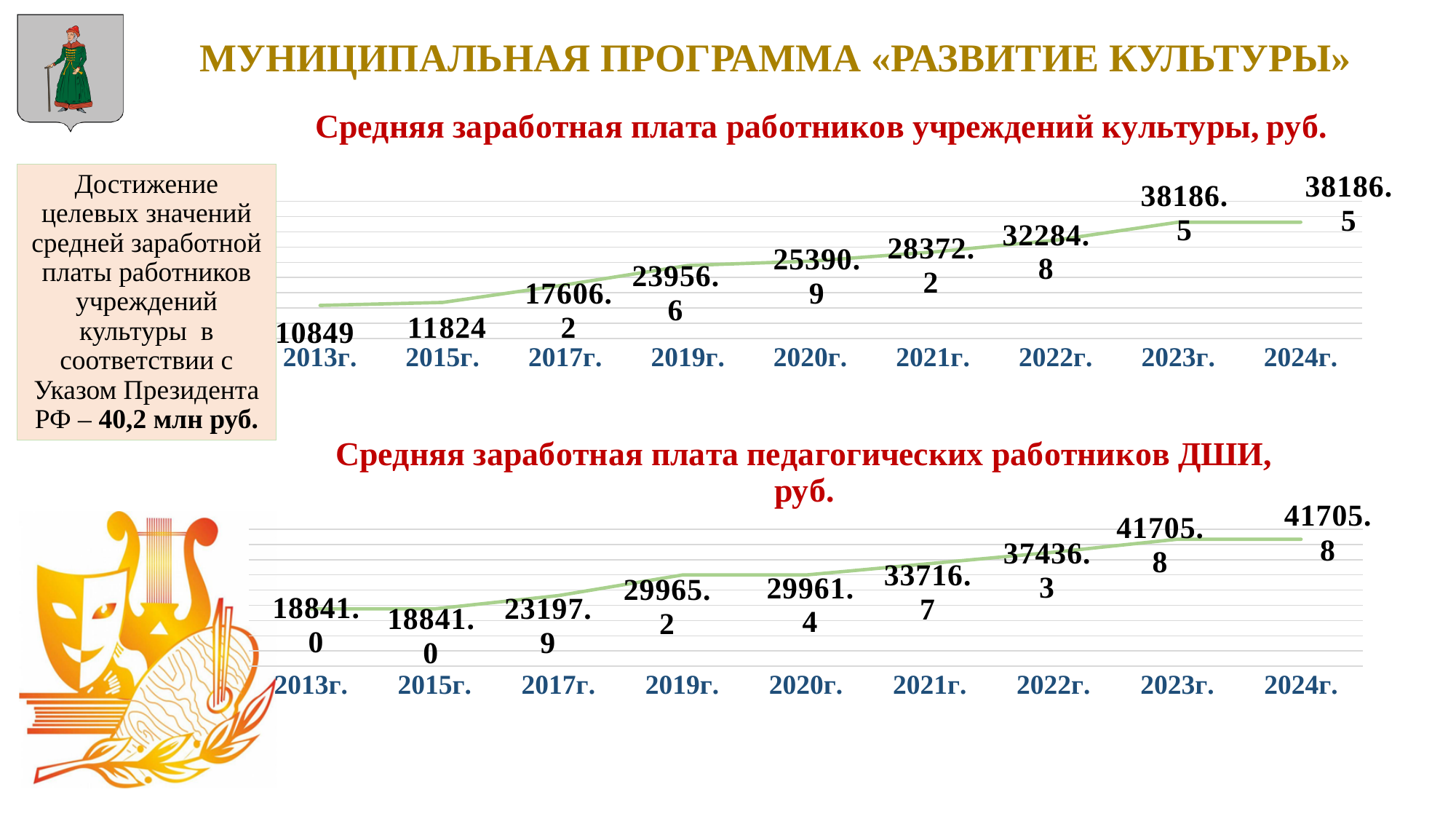
In the chart 'Средняя заработная плата работников учреждений культуры, руб.', what is the difference between the values for 2022г. and 2021г.? 3912.6 In the chart 'Средняя заработная плата педагогических работников ДШИ, руб.', what is the value for 2022г.? 37436.3 In the chart 'Средняя заработная плата работников учреждений культуры, руб.', which year has the lowest value? 2013г. In the chart 'Средняя заработная плата работников учреждений культуры, руб.', how many years are shown on the x axis? 9 What type of chart is 'Средняя заработная плата работников учреждений культуры, руб.'? line chart In the chart 'Средняя заработная плата педагогических работников ДШИ, руб.', which is larger, the value for 2019г. or the value for 2021г.? 2021г. In the chart 'Средняя заработная плата работников учреждений культуры, руб.', what is the value for 2021г.? 28372.2 In the chart 'Средняя заработная плата работников учреждений культуры, руб.', what is the value for 2024г.? 38186.5 In the chart 'Средняя заработная плата работников учреждений культуры, руб.', what is the value for 2013г.? 10849 In the chart 'Средняя заработная плата педагогических работников ДШИ, руб.', what is the value for 2017г.? 23197.9 In the chart 'Средняя заработная плата педагогических работников ДШИ, руб.', do the values generally rise or fall from 2013г. to 2024г.? rise In the chart 'Средняя заработная плата педагогических работников ДШИ, руб.', what is the difference between the values for 2023г. and 2013г.? 22864.8